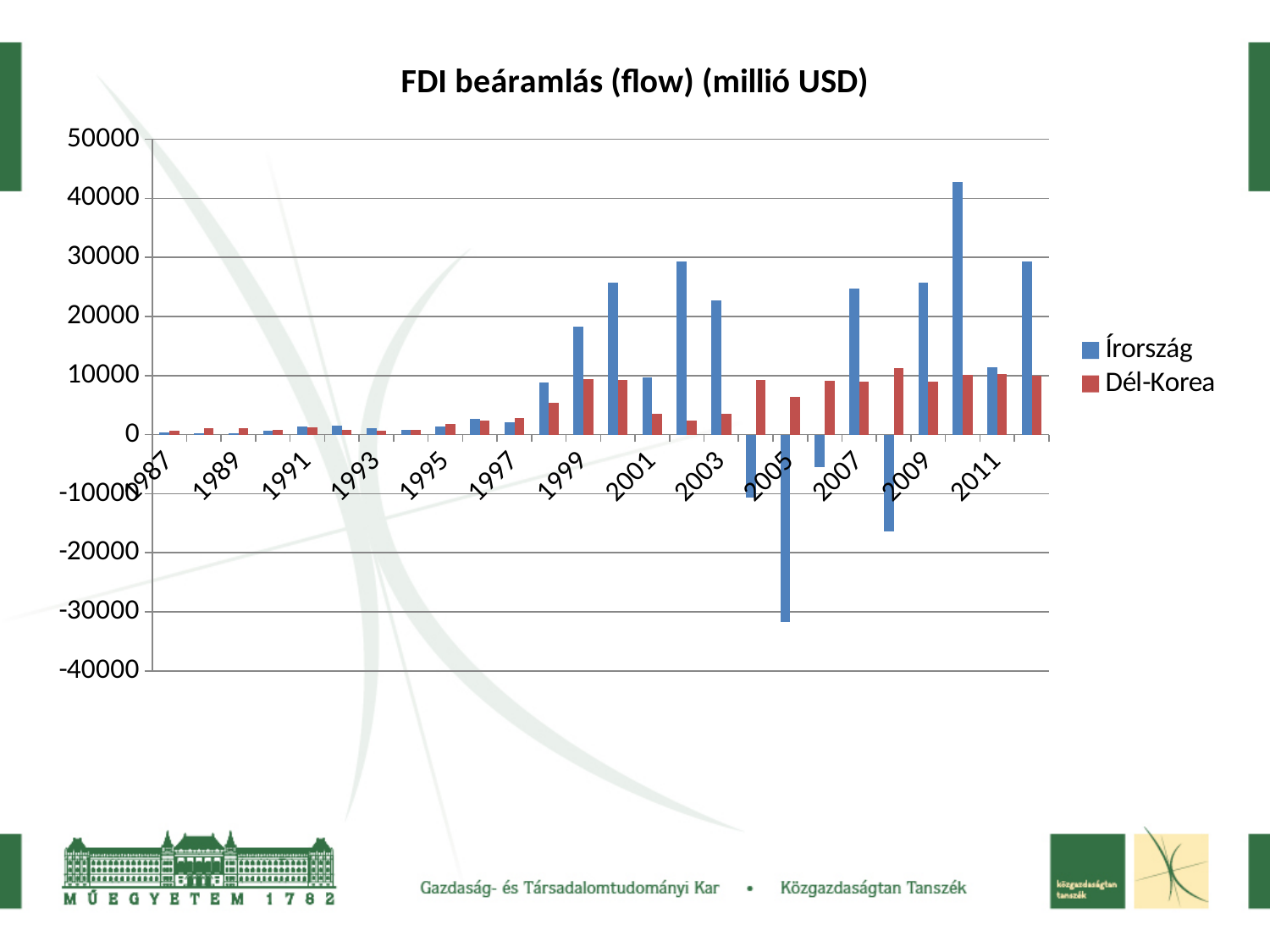
Is the value for Írország in 2010 greater or less than 40000? greater In 2005, which series has the larger value, Írország or Dél-Korea? Dél-Korea What is the title of the chart? FDI beáramlás (flow) (millió USD) Is the value for Írország in 2005 greater or less than -30000? less What kind of chart is shown on the slide? bar chart In 2010, which series has the larger value, Írország or Dél-Korea? Írország In which year does Írország have its lowest (most negative) FDI inflow? 2005 Is the value for Írország in 2002 greater or less than 20000? greater Which series is shown in blue? Írország In which year does Írország reach its highest FDI inflow? 2010 How many series does the legend list? 2